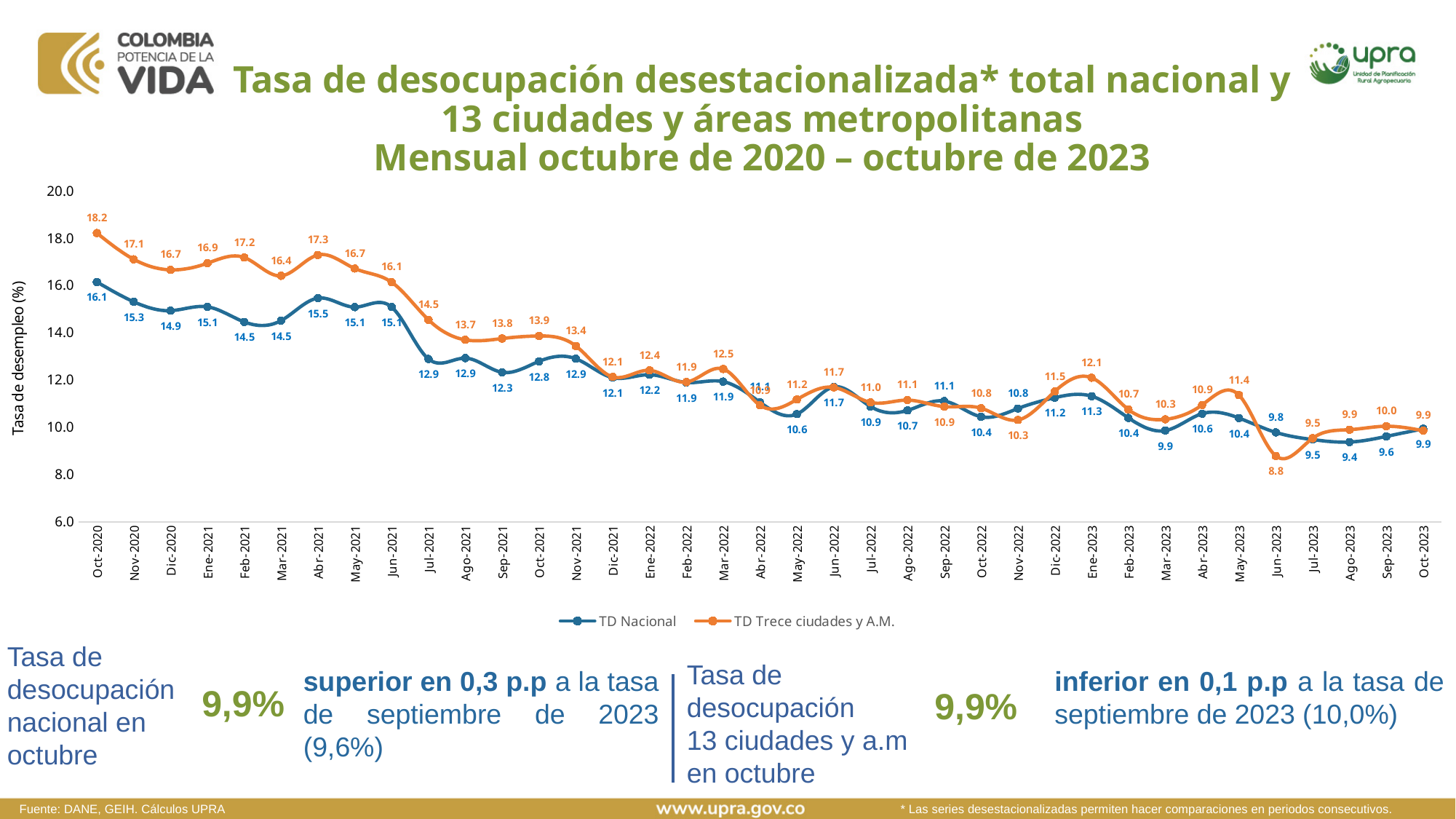
In which month does TD Nacional reach its highest value? Oct-2020 What is the value of TD Nacional in Sep-2023? 9.6 How many series does the legend list? 2 What is the label of the y axis? Tasa de desempleo (%) What type of chart is shown on the slide? Line chart Which series has the higher value in Jun-2023, TD Nacional or TD Trece ciudades y A.M.? TD Nacional What is the difference between TD Trece ciudades y A.M. and TD Nacional in Oct-2020? 2.1 In which month does TD Trece ciudades y A.M. reach its lowest value? Jun-2023 What is the value of TD Nacional in Oct-2023? 9.9 Does TD Nacional generally rise or fall from Oct-2020 to Oct-2023? Fall What is the value of TD Trece ciudades y A.M. in Oct-2020? 18.2 How many monthly data points does each series have? 37